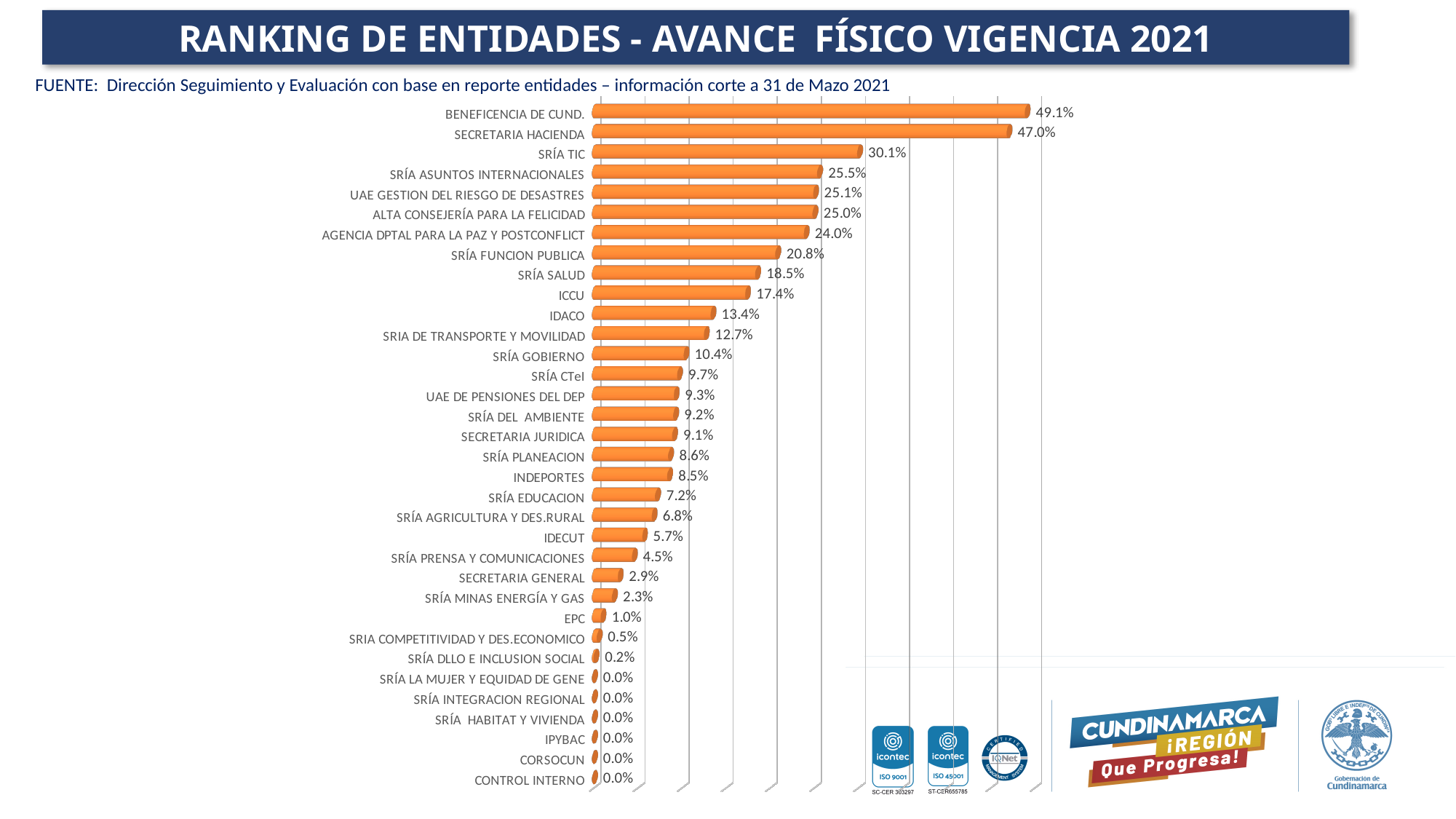
What is the difference between the values for SRÍA TIC and SRÍA GOBIERNO? 19.7% What is the title of the slide? RANKING DE ENTIDADES - AVANCE FÍSICO VIGENCIA 2021 How many entities are shown in the chart? 34 What is the difference between the values for BENEFICENCIA DE CUND. and SECRETARIA HACIENDA? 2.1% Which is larger, the value for SRÍA EDUCACION or the value for SRÍA PLANEACION? SRÍA PLANEACION What is the value for SRÍA SALUD? 18.5% What kind of chart is shown on the slide? Bar chart Which is larger, the value for ICCU or the value for IDACO? ICCU How many entities have a value of 0.0%? 6 What is the value for IDECUT? 5.7% Which entity has the highest value? BENEFICENCIA DE CUND. What is the value for SECRETARIA HACIENDA? 47.0%